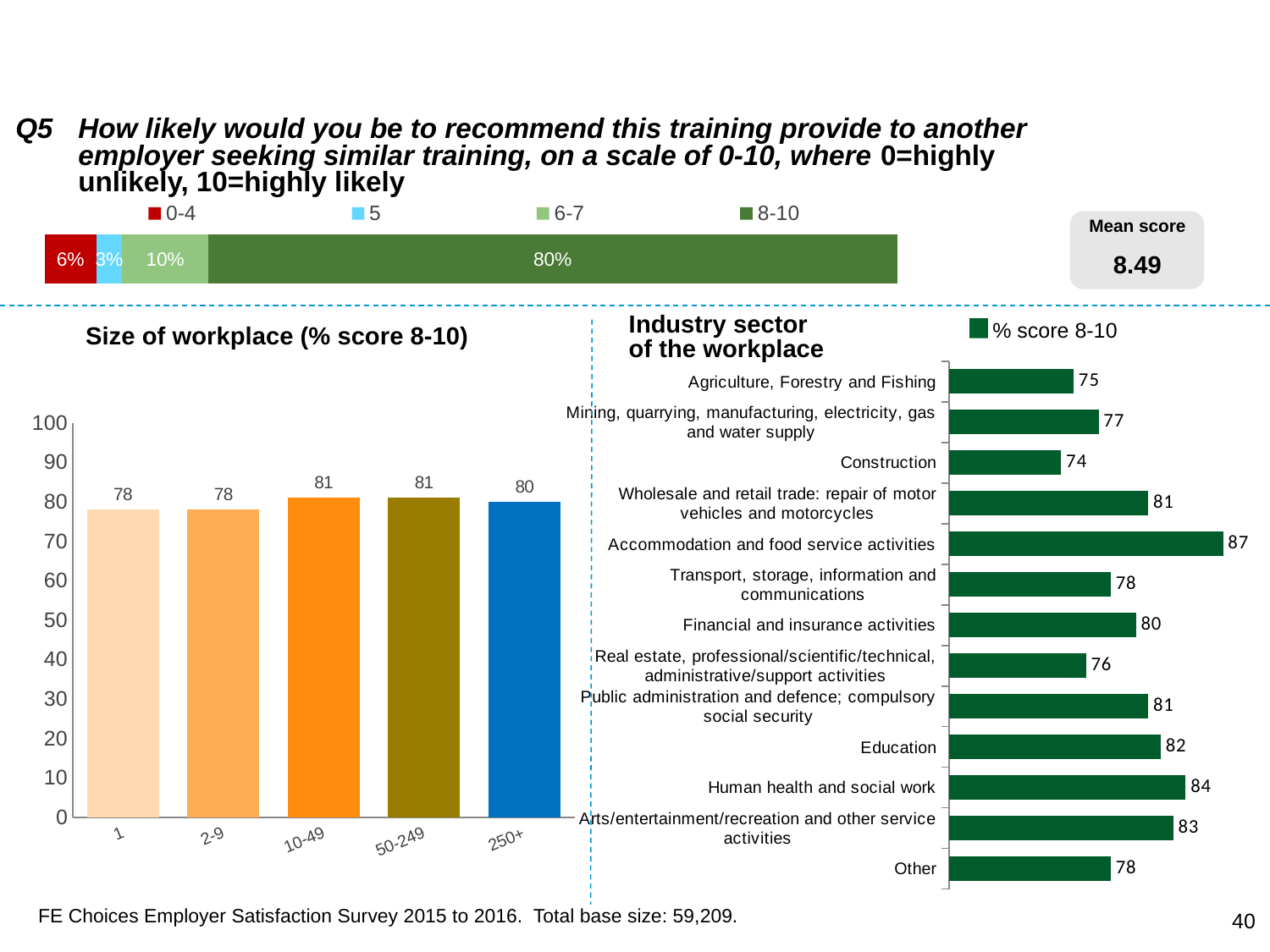
In the 'Size of workplace (% score 8-10)' chart, what is the value for workplaces of size 250+? 80 In the 'Industry sector of the workplace' chart, what is the value for Education? 82 In the 'Industry sector of the workplace' chart, which is larger: Financial and insurance activities or Real estate, professional/scientific/technical, administrative/support activities? Financial and insurance activities In the 'Industry sector of the workplace' chart, which sector has the highest % score 8-10? Accommodation and food service activities In the 'Industry sector of the workplace' chart, which sector has the lowest % score 8-10? Construction How many series does the legend of the stacked bar at the top of the slide list? 4 How many bars are in the 'Size of workplace (% score 8-10)' chart? 5 In the 'Size of workplace (% score 8-10)' chart, what is the value for workplaces of size 2-9? 78 How many sectors are shown in the 'Industry sector of the workplace' chart? 13 In the 'Industry sector of the workplace' chart, what is the difference between Human health and social work and Agriculture, Forestry and Fishing? 9 What kind of chart is the 'Size of workplace (% score 8-10)' chart? Bar chart In the stacked bar at the top of the slide, what percentage of respondents gave a score of 8-10? 80%